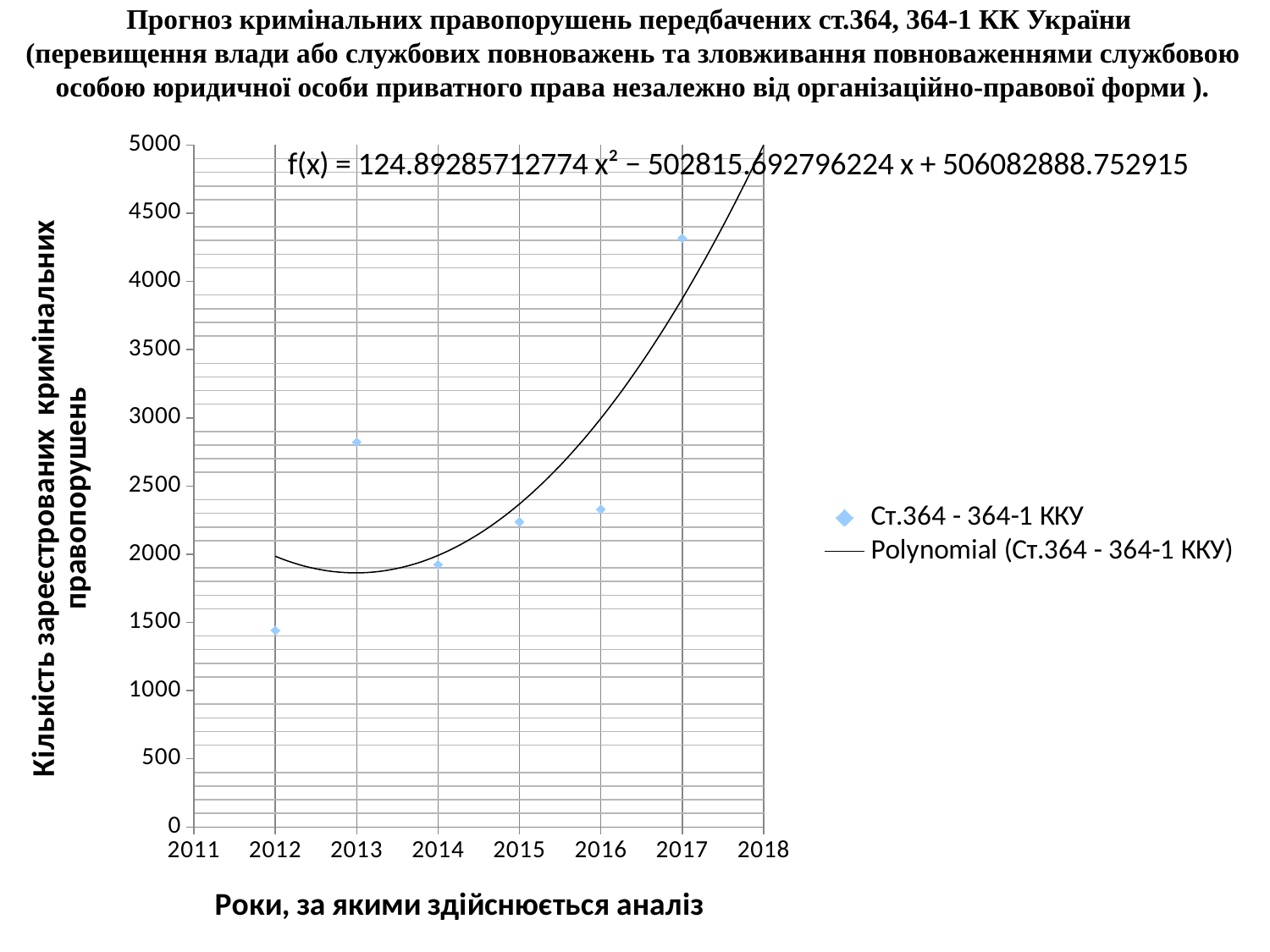
How many data points are plotted for the series Ст.364 - 364-1 ККУ? 6 Which year has the highest number of registered offences? 2017 What kind of chart is shown on the slide? scatter chart What is the title of the x axis? Роки, за якими здійснюється аналіз How many entries does the legend list? 2 Which year has the lowest number of registered offences? 2012 Is the value for 2014 greater or less than 2000? less Is the value for 2017 greater or less than 4000? greater Is the value for 2013 greater or less than 2500? greater Does the polynomial trendline rise or fall between 2014 and 2018? rises Which year has a larger value, 2013 or 2014? 2013